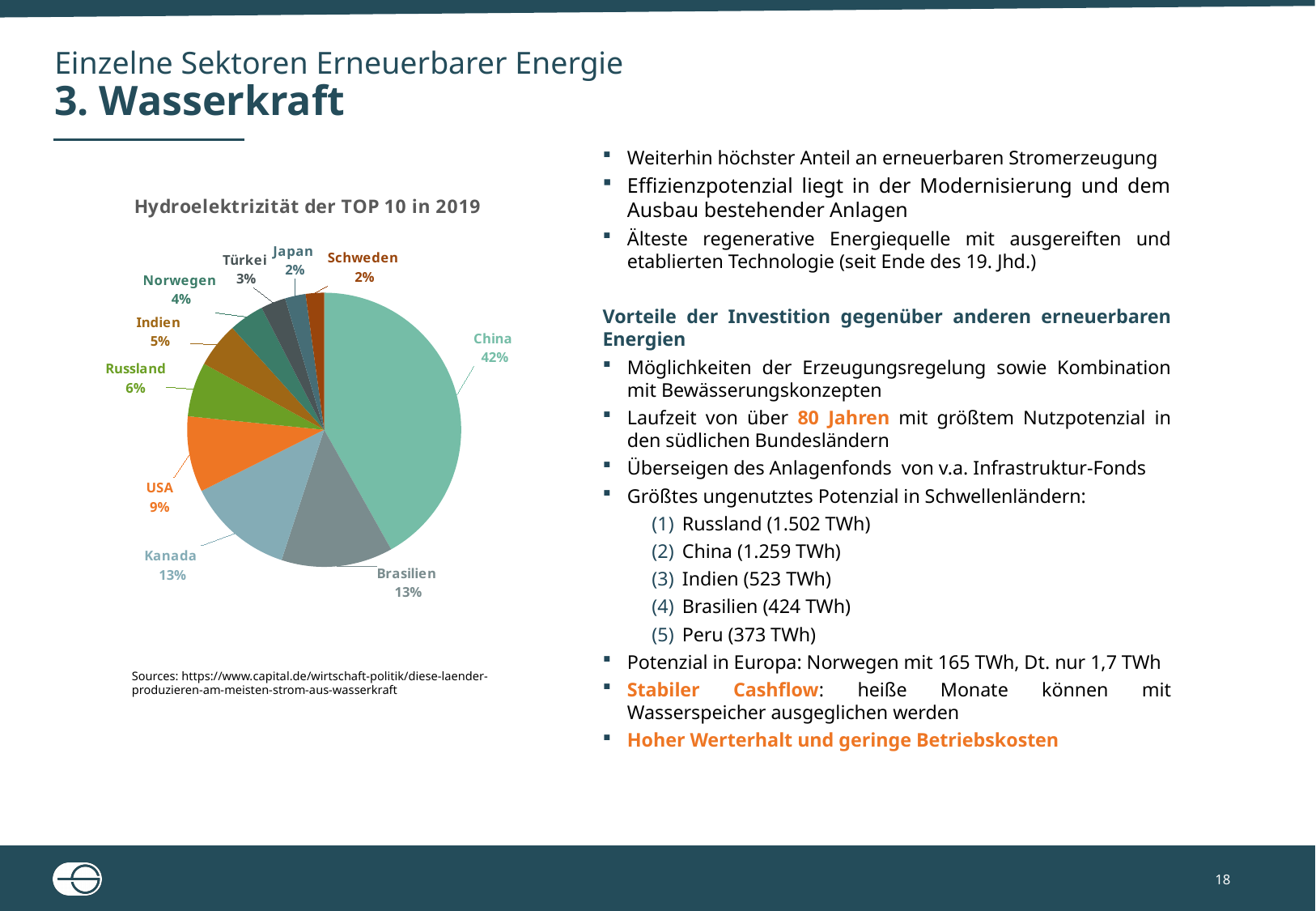
How many countries (slices) are shown in the pie chart? 10 What is the difference in percentage points between China and Kanada? 29 What is the title of the chart? Hydroelektrizität der TOP 10 in 2019 What share of the pie does China have? 42% What is the value shown for Türkei? 3% What is the value shown for USA? 9% Which has a larger share, USA or Russland? USA What is the value shown for Norwegen? 4% What is the difference in percentage points between Russland and Indien? 1 What is the value shown for Brasilien? 13% Which country has the largest slice of the pie? China What kind of chart is shown on the slide? pie chart